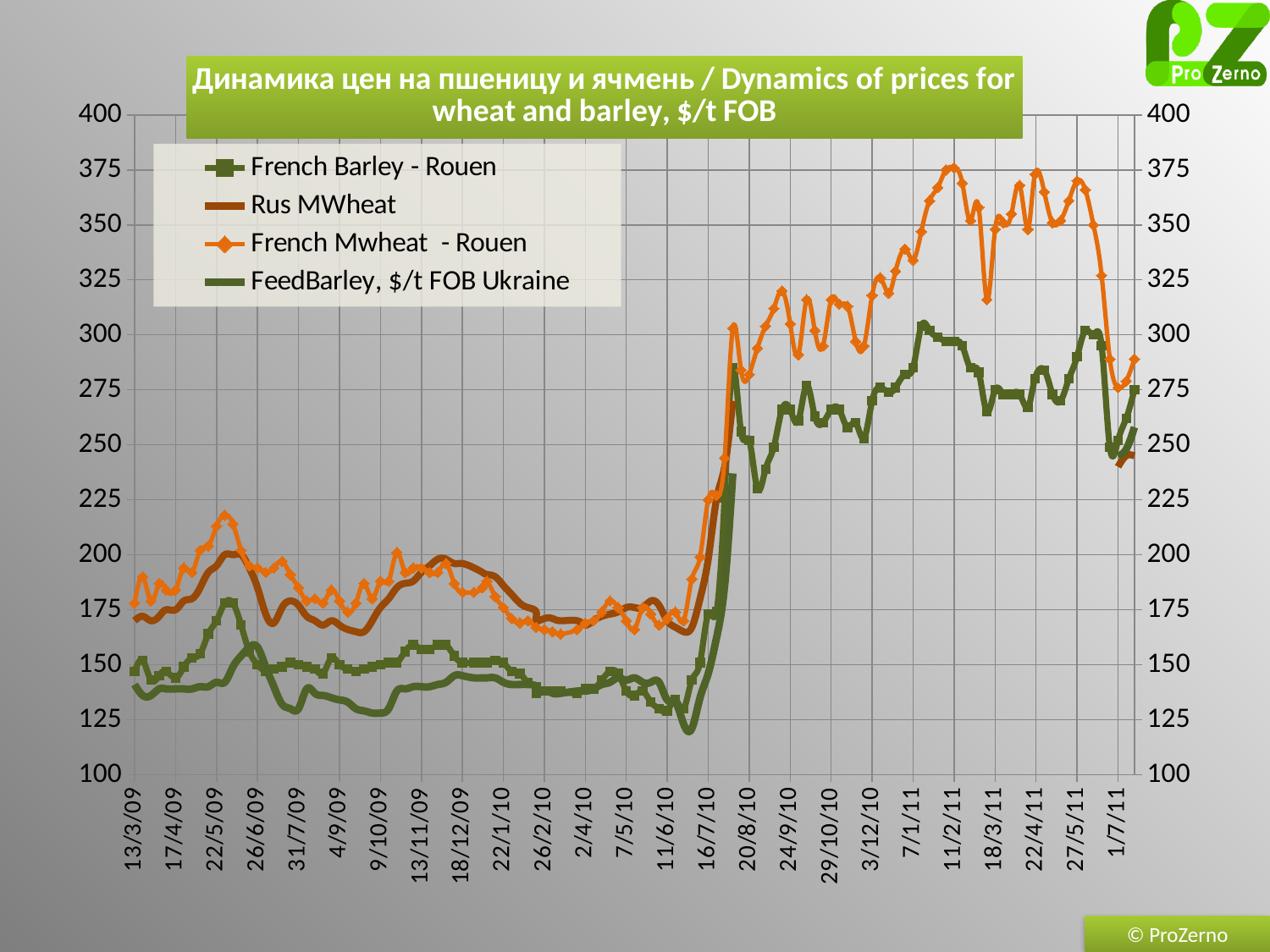
At 11/2/11, which is larger: French Mwheat - Rouen or French Barley - Rouen? French Mwheat - Rouen Is the lowest value of FeedBarley, $/t FOB Ukraine in mid-2010 greater or less than 125? less How many series does the legend list? 4 Which series is drawn in orange with diamond markers according to the legend? French Mwheat - Rouen Is the peak value of French Mwheat - Rouen around 11/2/11 greater or less than 350? greater What unit of price is given in the chart title? $/t FOB Is the value of Rus MWheat at 13/3/09 greater or less than 150? greater Which series reaches the highest value anywhere on the chart? French Mwheat - Rouen Do French Mwheat - Rouen prices rise or fall between 11/6/10 and 20/8/10? rise What kind of chart is shown on the slide? line chart Which series drops to the lowest value anywhere on the chart? FeedBarley, $/t FOB Ukraine